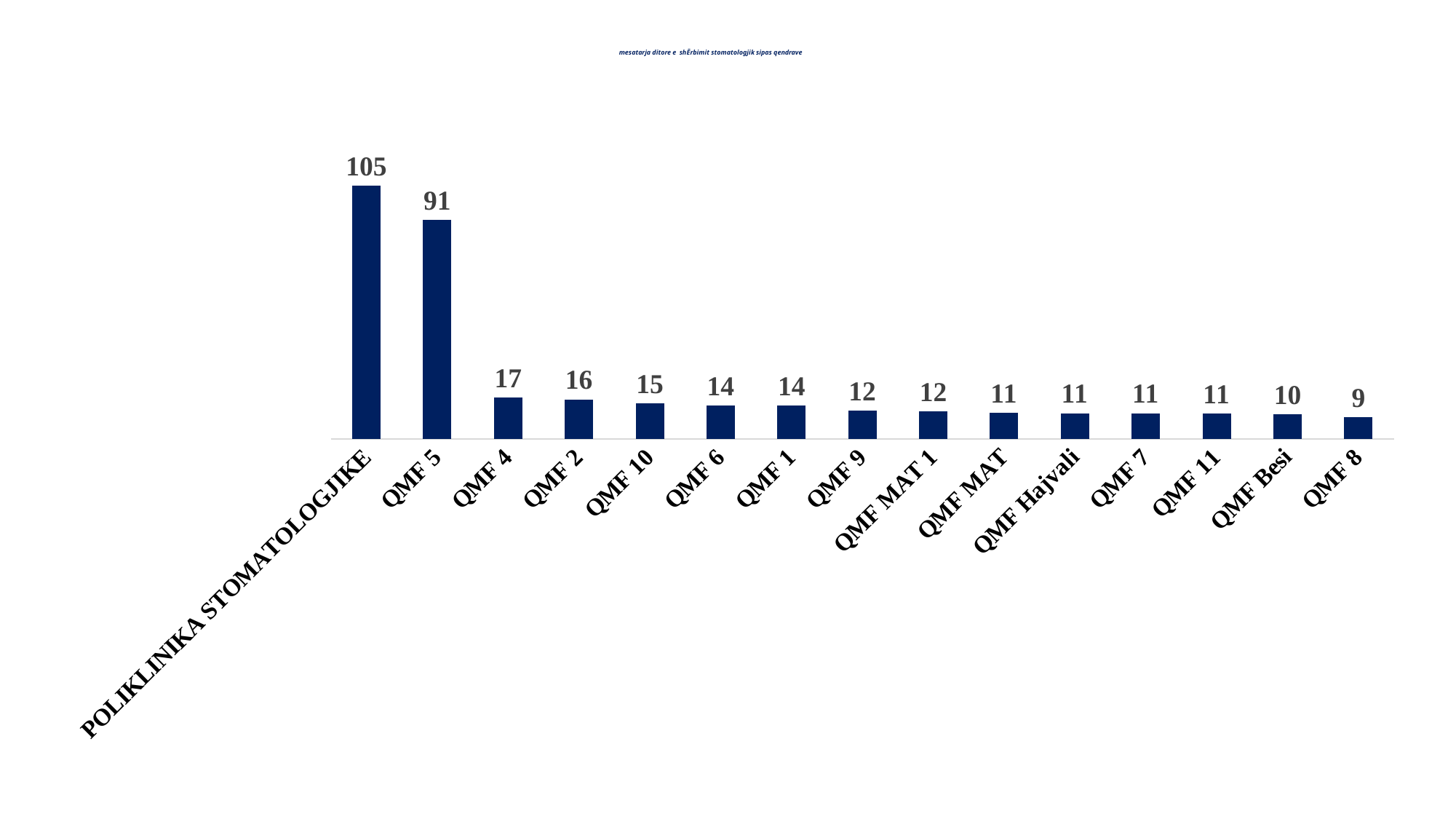
What is the value for QMF Besi? 10 Which category has the lowest value? QMF 8 Which category has the highest value? POLIKLINIKA STOMATOLOGJIKE Do the values rise or fall from left to right along the x axis? Fall What is the value for POLIKLINIKA STOMATOLOGJIKE? 105 What is the difference between the values for QMF 4 and QMF 8? 8 What kind of chart is shown on the slide? Bar chart Which is larger, the value for QMF 4 or the value for QMF 10? QMF 4 How many categories are shown on the x axis? 15 What is the difference between the values for POLIKLINIKA STOMATOLOGJIKE and QMF 5? 14 What is the value for QMF Hajvali? 11 What is the value for QMF 5? 91